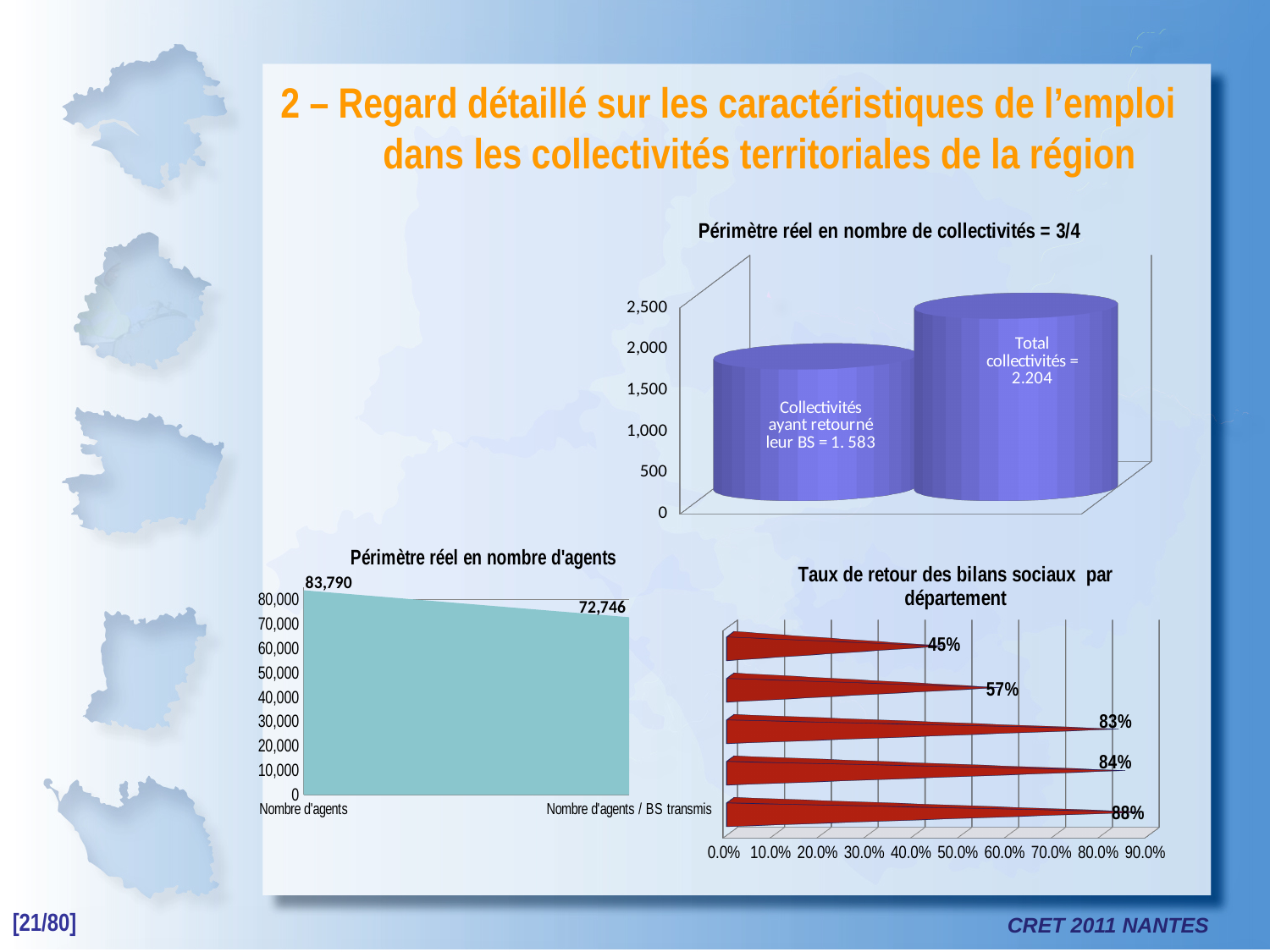
In the chart 'Taux de retour des bilans sociaux par département', what is the difference between the highest and lowest return rates? 43% In the chart 'Périmètre réel en nombre de collectivités = 3/4', what is the value for 'Total collectivités'? 2.204 In the chart 'Périmètre réel en nombre d'agents', do the values rise or fall from left to right along the x axis? fall In the chart 'Taux de retour des bilans sociaux par département', what is the highest return rate shown? 88% In the chart 'Taux de retour des bilans sociaux par département', how many departments (bars) are plotted? 5 In the chart 'Périmètre réel en nombre d'agents', what is the value for 'Nombre d'agents / BS transmis'? 72,746 In the chart 'Taux de retour des bilans sociaux par département', what is the lowest return rate shown? 45% In the chart 'Périmètre réel en nombre d'agents', what is the value for 'Nombre d'agents'? 83,790 In the chart 'Périmètre réel en nombre de collectivités = 3/4', is the value for 'Collectivités ayant retourné leur BS' greater or less than 2,000? less In the chart 'Périmètre réel en nombre de collectivités = 3/4', what is the value for 'Collectivités ayant retourné leur BS'? 1. 583 In the chart 'Périmètre réel en nombre d'agents', what is the difference between 'Nombre d'agents' and 'Nombre d'agents / BS transmis'? 11,044 In the chart 'Périmètre réel en nombre de collectivités = 3/4', which of the two bars is taller? Total collectivités